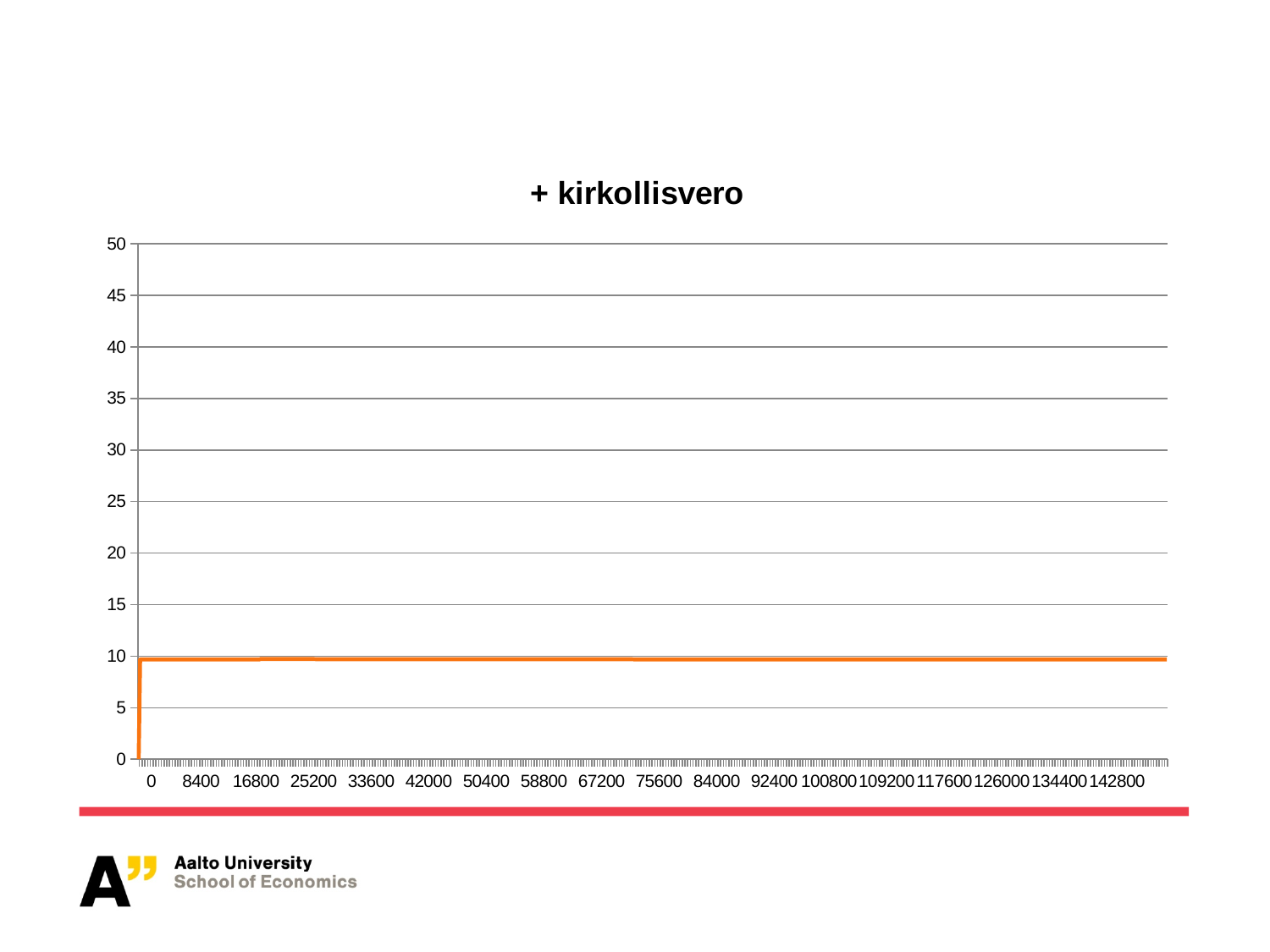
Is the value for 126000 greater or less than 20? less Is the value for 42000 greater or less than 15? less What is the highest value shown on the y axis? 50 What kind of chart is shown on the slide? line chart Is the value for 16800 greater or less than 30? less What colour is the plotted line in the chart? orange What is the title of the chart? + kirkollisvero After the initial jump at the start, do the values rise, fall, or stay roughly flat along the x axis? stay roughly flat